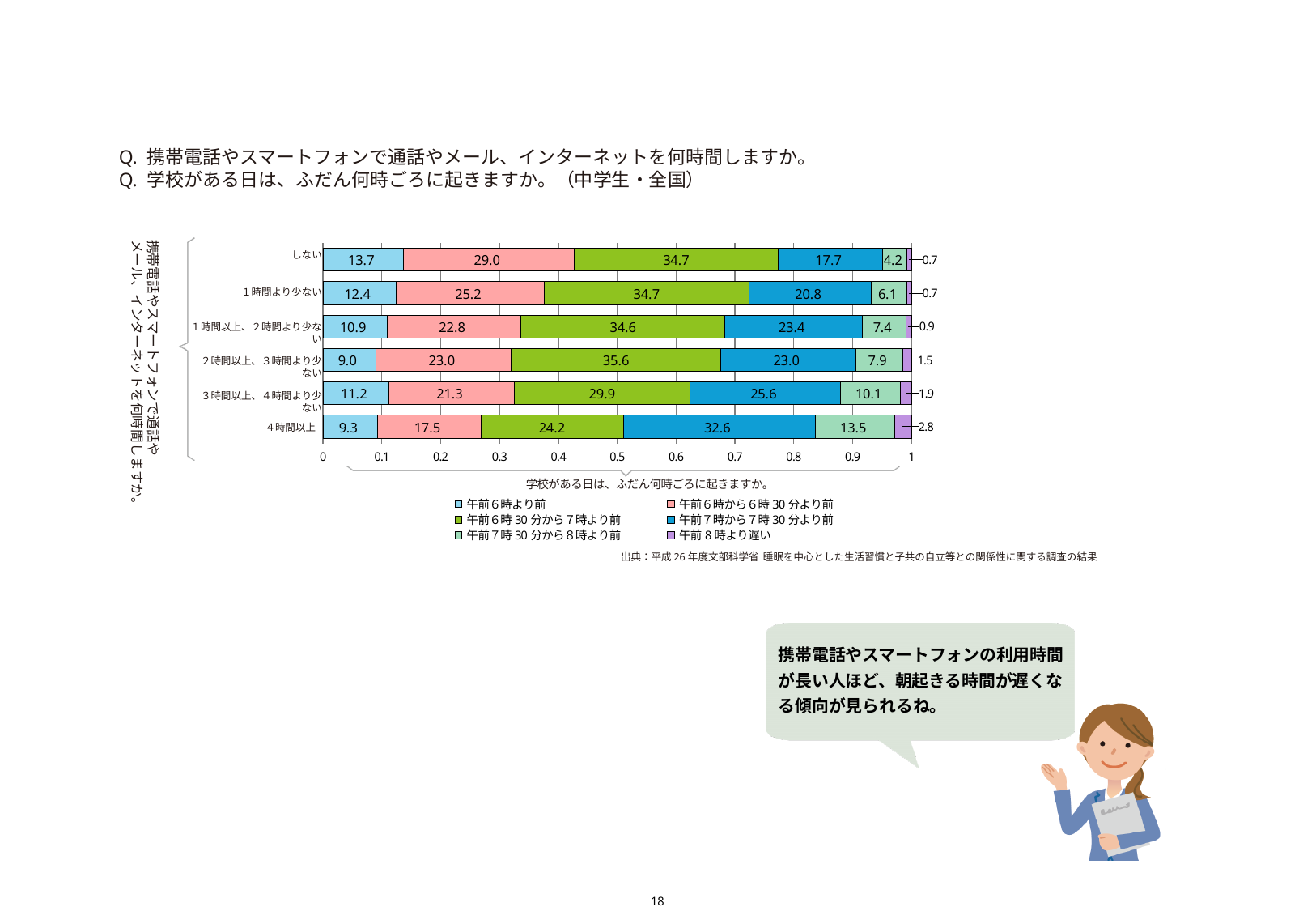
利用時間が長くなるにつれて「午前7時から7時30分より前」の値はどのように変化していますか。 増加している 「午前6時より前」の値が最も小さい利用時間の区分はどれですか。 2時間以上、3時間より少ない このグラフはどの種類のグラフですか。 積み上げ棒グラフ グラフには携帯電話の利用時間の区分がいくつありますか。 6 「2時間以上、3時間より少ない」の「午前6時30分から7時より前」の値はいくつですか。 35.6 「しない」の「午前6時より前」の値はいくつですか。 13.7 「しない」と「4時間以上」の「午前6時から6時30分より前」の値の差はいくつですか。 11.5 「午前8時より遅い」の値が最も大きい利用時間の区分はどれですか。 4時間以上 凡例にはいくつの系列が示されていますか。 6 「午前7時30分から8時より前」の値は「3時間以上、4時間より少ない」と「1時間より少ない」のどちらが大きいですか。 3時間以上、4時間より少ない 凡例で「午前6時30分から7時より前」は何色で示されていますか。 緑 「4時間以上」の「午前7時から7時30分より前」の値はいくつですか。 32.6